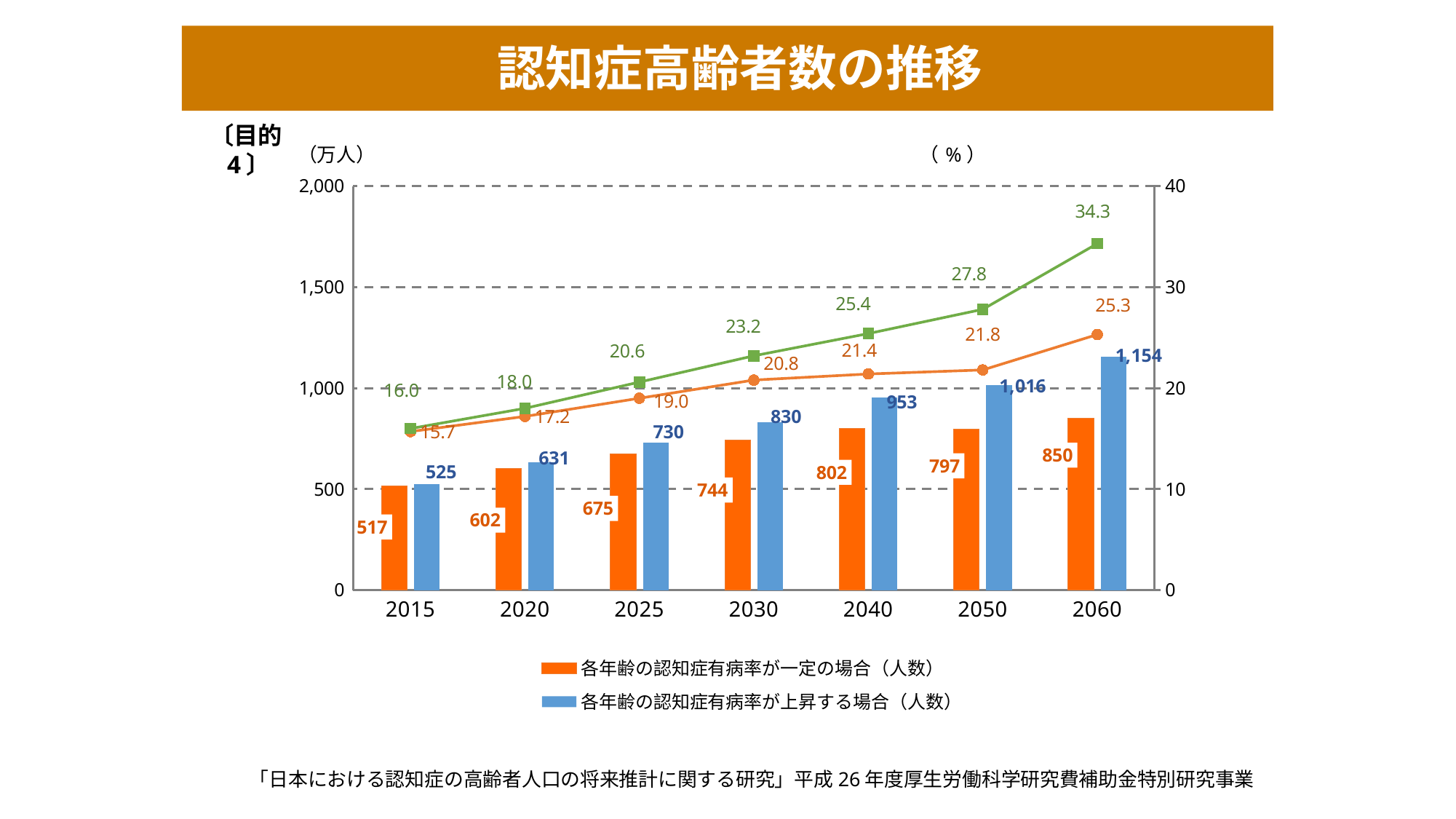
What is the title of the chart? 認知症高齢者数の推移 How many years are shown on the x axis? 7 Does the green line rise or fall from 2015 to 2060? rise What is the value of the orange line for 2025? 19.0 How many series does the legend list? 2 Which is larger for 2040: the orange bar or the blue bar? the blue bar What is the value of the green line for 2040? 25.4 What is the difference between the blue bar and the orange bar for 2050? 219 In which year is the orange bar (各年齢の認知症有病率が一定の場合) lowest? 2015 What is the value of the orange bar (各年齢の認知症有病率が一定の場合) for 2015? 517 What is the value of the blue bar (各年齢の認知症有病率が上昇する場合) for 2060? 1,154 In which year is the blue bar (各年齢の認知症有病率が上昇する場合) highest? 2060